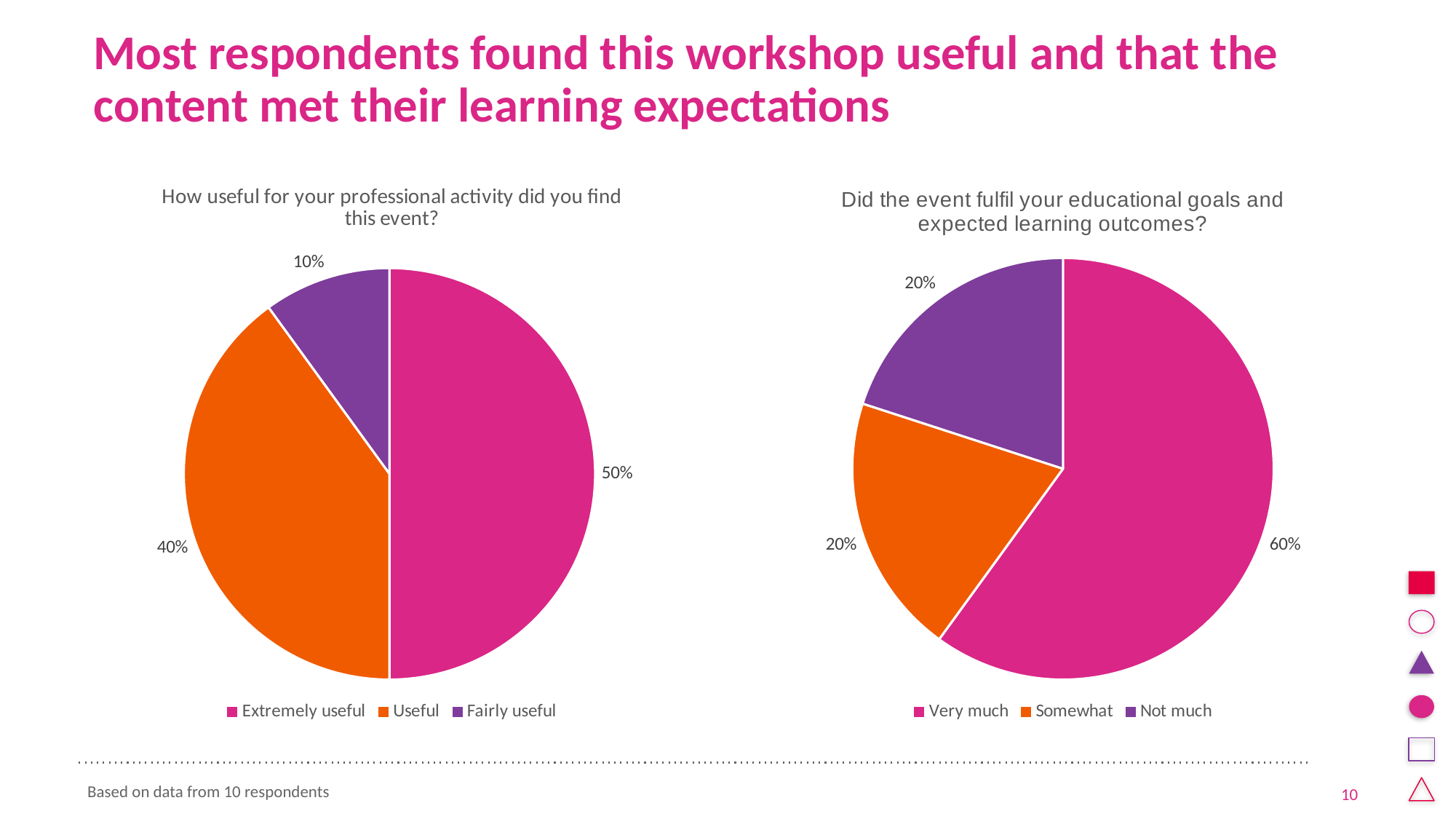
In the right chart, what is the difference in percentage points between "Very much" and "Not much"? 40 In the left chart, which category has the smallest slice? Fairly useful In the right chart, what colour is the "Not much" slice? Purple In the left chart, which is larger: the share for "Useful" or the share for "Fairly useful"? Useful What type of chart is used on the left side of the slide? Pie chart In the chart titled "How useful for your professional activity did you find this event?", what share of respondents answered "Fairly useful"? 10% In the chart titled "Did the event fulfil your educational goals and expected learning outcomes?", what share of respondents answered "Somewhat"? 20% In the right chart, which category has the largest slice? Very much In the left chart, what is the difference in percentage points between "Extremely useful" and "Useful"? 10 In the chart titled "How useful for your professional activity did you find this event?", what share of respondents answered "Extremely useful"? 50% How many categories does the right chart's legend list? 3 In the chart titled "Did the event fulfil your educational goals and expected learning outcomes?", what share of respondents answered "Very much"? 60%